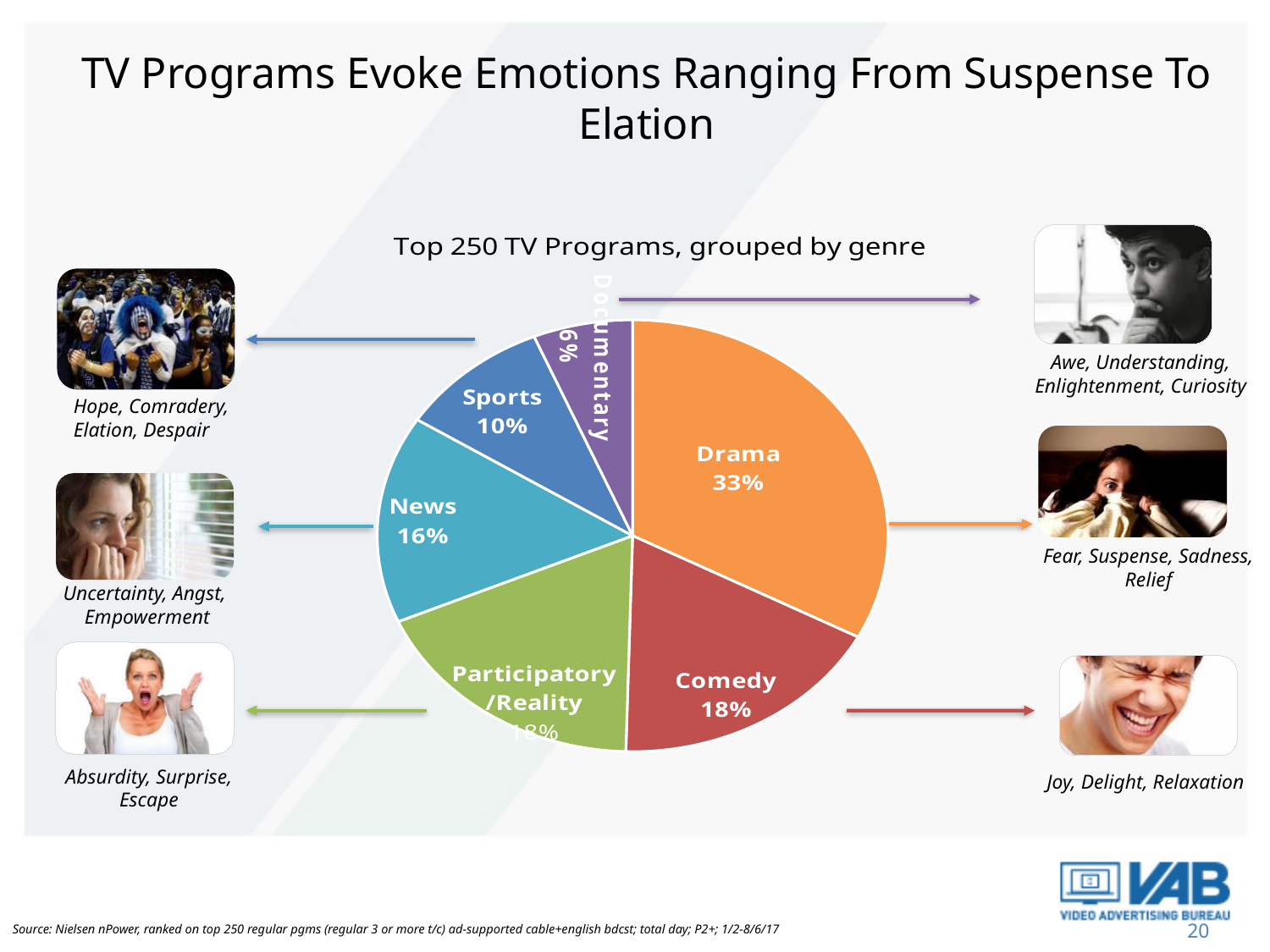
Which slice is larger, News or Sports? News What percentage of the pie is Sports? 10% Which genre has the smallest slice of the pie? Documentary What kind of chart is shown on the slide? Pie chart How many genre slices does the pie chart have? 6 What is the title of the chart? Top 250 TV Programs, grouped by genre What share of the top 250 TV programs is Drama? 33% How many percentage points larger is Drama than Comedy? 15 Which genre has the largest slice of the pie? Drama What percentage of the pie is News? 16% What percentage of the pie is Documentary? 6% What percentage of the pie is Comedy? 18%